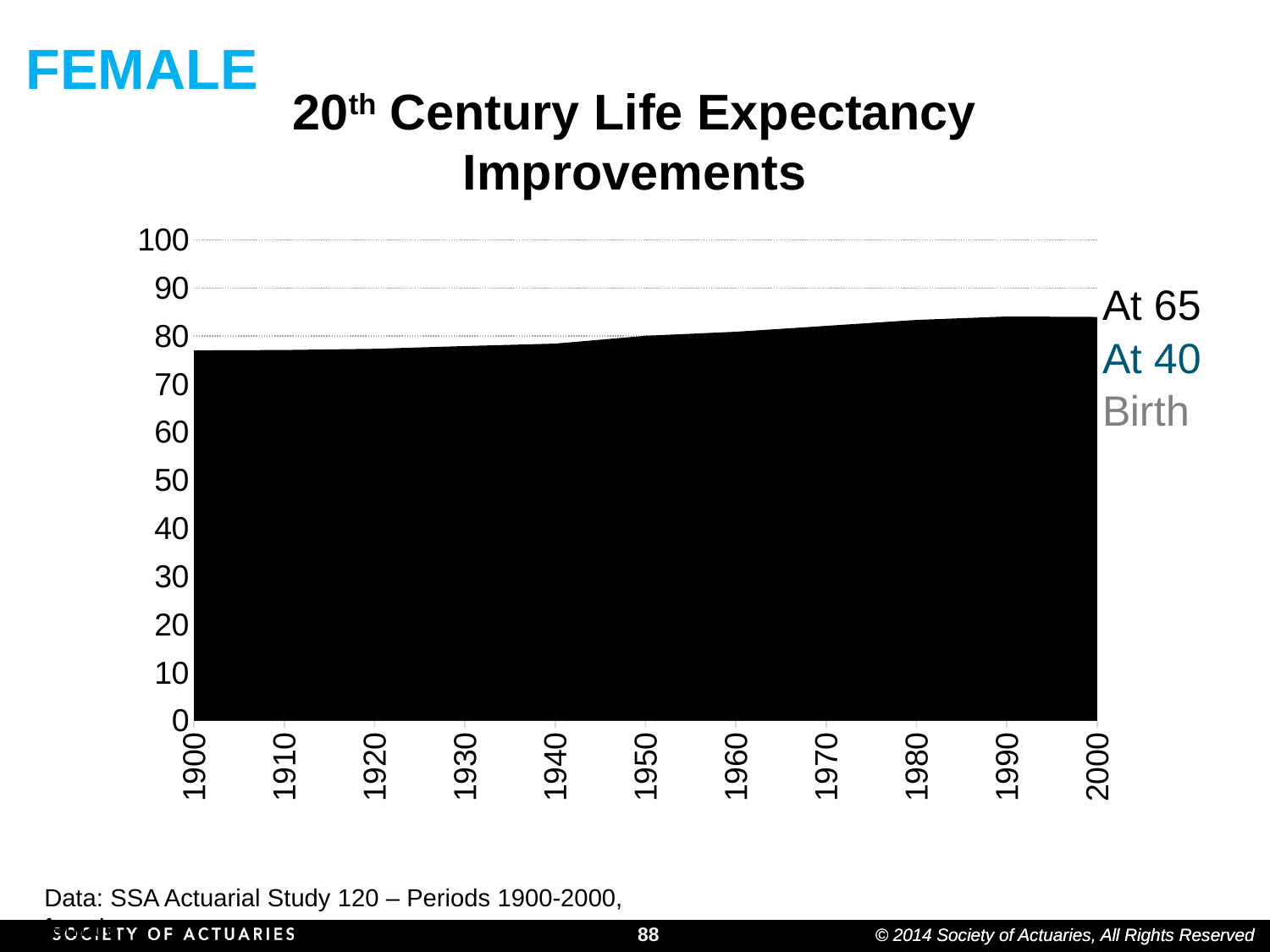
What are the three legend entries on the chart? At 65, At 40, Birth Is the highest plotted value in 2000 greater or less than 90? less Is the highest plotted value in 2000 greater or less than 80? greater Is the highest plotted value in 1900 greater or less than 80? less How many year labels are shown along the x axis? 11 Which year is the first label on the x axis? 1900 Does the top edge of the plotted area rise or fall from 1900 to 2000? rise What is the maximum value shown on the y axis? 100 What is the title of the chart? 20th Century Life Expectancy Improvements How many series does the legend list? 3 What kind of chart is shown on the slide? area chart